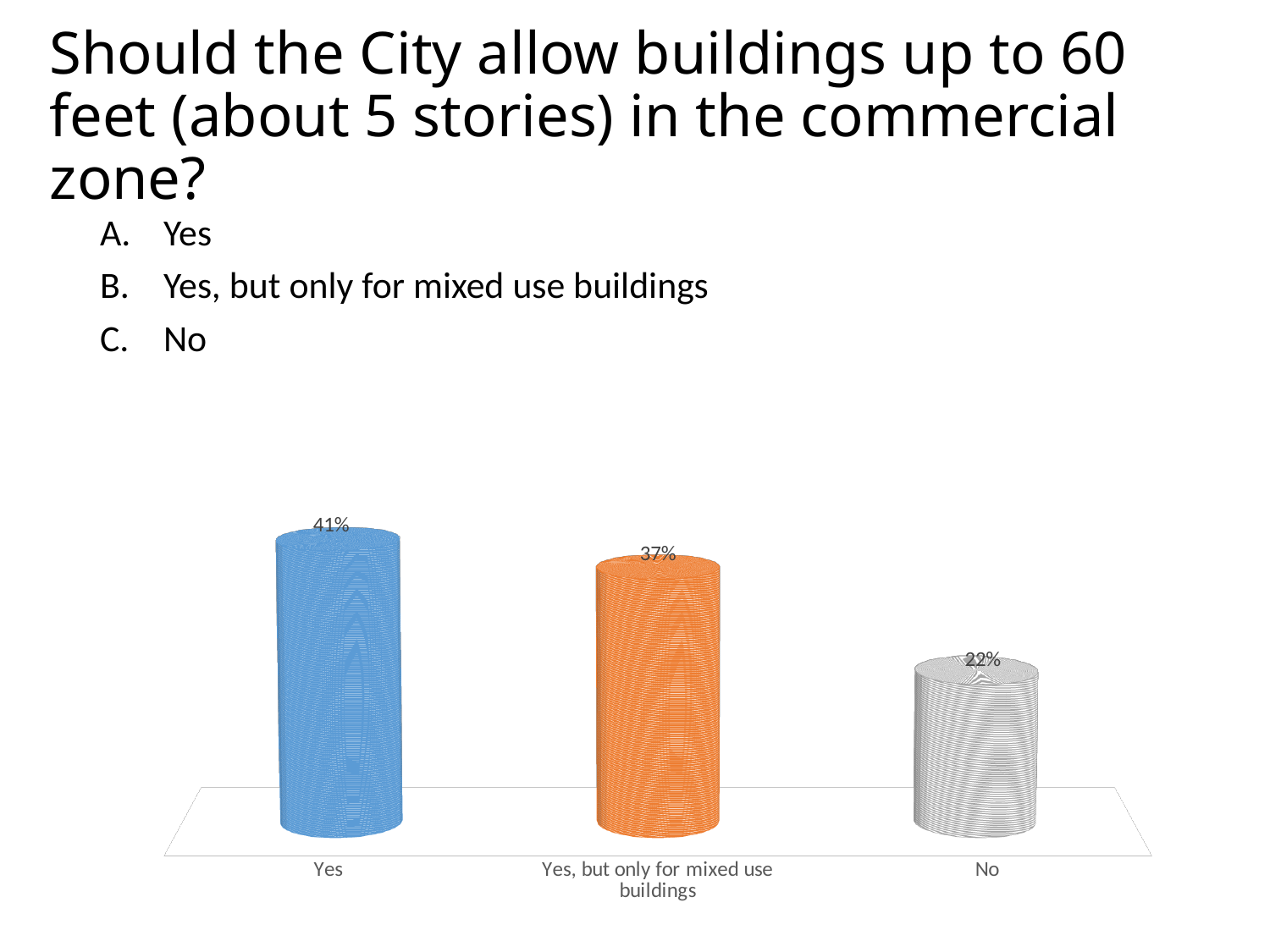
What percentage of respondents answered "Yes"? 41% Which is larger: the percentage for "Yes, but only for mixed use buildings" or the percentage for "No"? Yes, but only for mixed use buildings What percentage of respondents answered "No"? 22% Do the values rise or fall moving from left to right across the categories? Fall What colour is the bar for the "No" response? Grey Which response received the highest percentage? Yes How many response categories are shown in the chart? 3 Which response received the lowest percentage? No What kind of chart is shown on the slide? Bar chart What is the difference in percentage points between "Yes" and "No"? 19 What is the difference in percentage points between "Yes" and "Yes, but only for mixed use buildings"? 4 What percentage of respondents answered "Yes, but only for mixed use buildings"? 37%